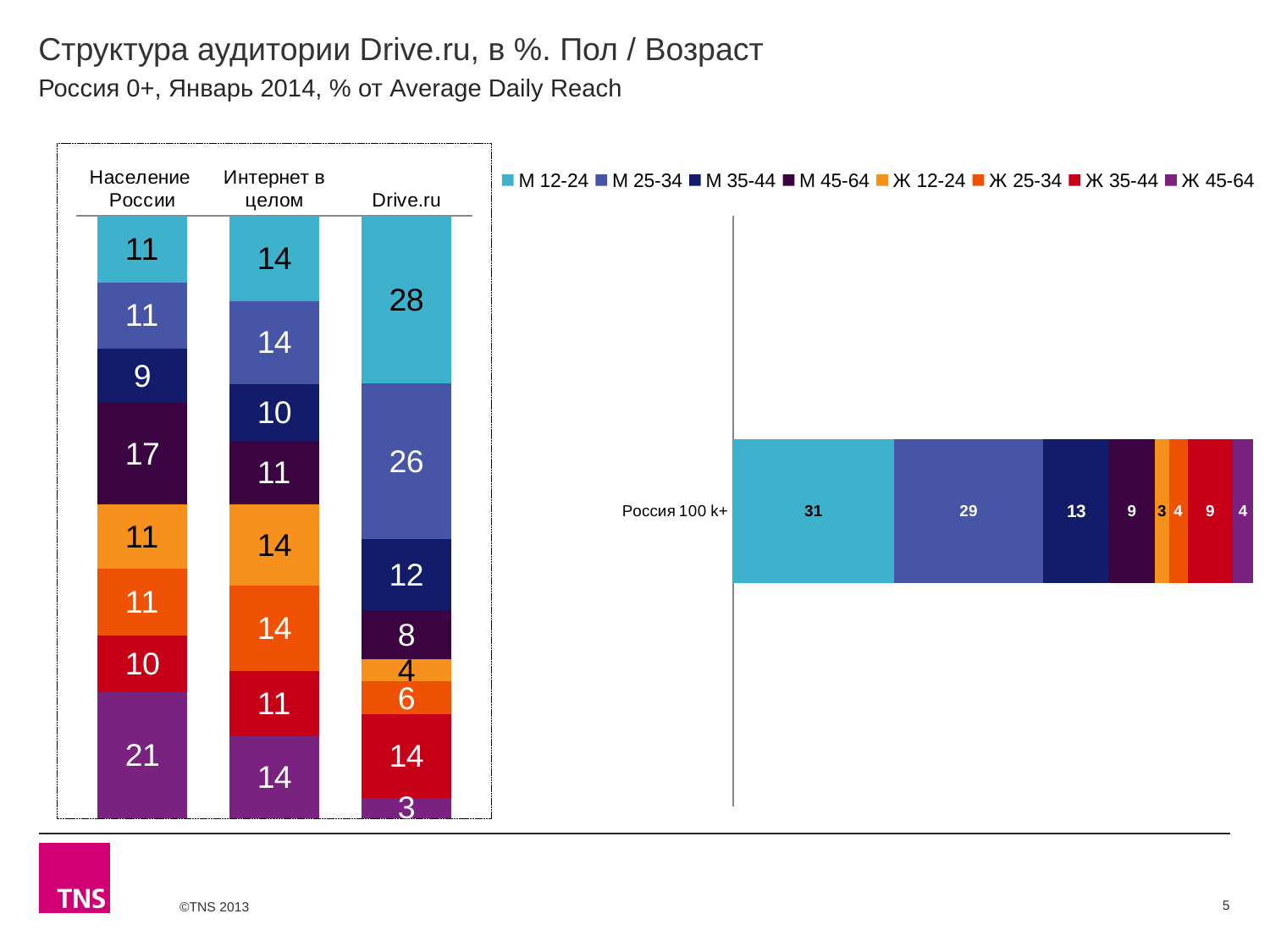
What kind of chart is the right chart (Россия 100 k+)? Stacked bar chart In the left chart, what is the value for М 12-24 in the Drive.ru column? 28 How many columns (categories) are shown in the left chart? 3 In the left chart, what is the difference between the М 12-24 values for Drive.ru and Население России? 17 In the right chart (Россия 100 k+), what is the value for М 25-34? 29 In the left chart, which is larger: Ж 35-44 for Drive.ru or Ж 35-44 for Интернет в целом? Drive.ru In the left chart, what is the value for Ж 45-64 in the Население России column? 21 In the right chart (Россия 100 k+), what is the total of the М 35-44 and М 45-64 segments? 22 In the left chart, which segment of the Drive.ru column has the largest value? М 12-24 In the left chart, which segment of the Drive.ru column has the smallest value? Ж 45-64 In the right chart (Россия 100 k+), which segment has the largest value? М 12-24 How many series does the legend list? 8